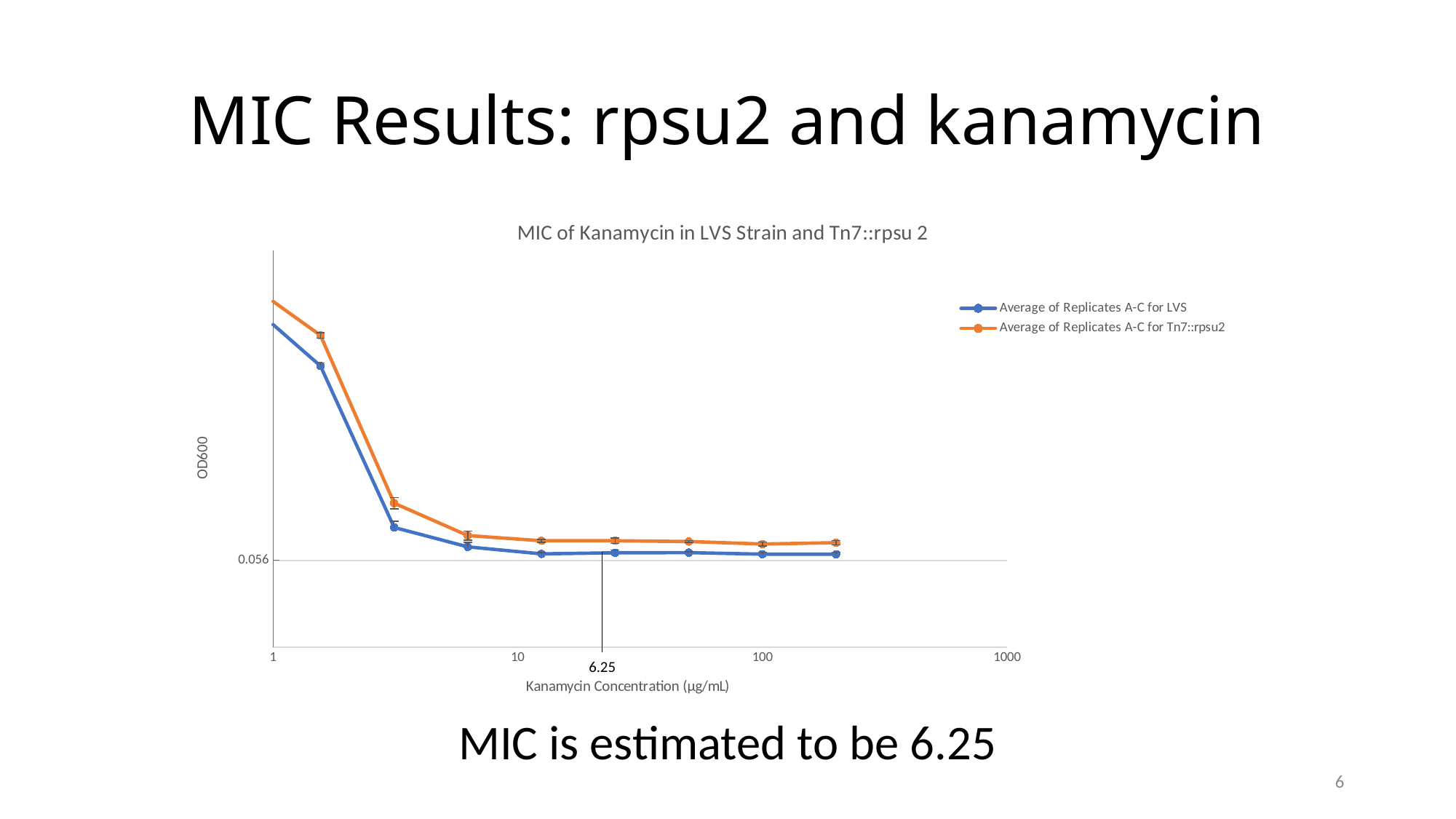
How many data points are plotted for each series? 8 Which series has the lower OD600 values across the concentration range? Average of Replicates A-C for LVS Do the OD600 values rise or fall as kanamycin concentration increases? fall At a kanamycin concentration of 1 µg/mL, which series has the higher OD600: Average of Replicates A-C for LVS or Average of Replicates A-C for Tn7::rpsu2? Average of Replicates A-C for Tn7::rpsu2 Is the OD600 value for Average of Replicates A-C for LVS at 1 µg/mL greater or less than 0.056? greater What is the title of the chart? MIC of Kanamycin in LVS Strain and Tn7::rpsu 2 At the highest plotted concentration, which series has the higher OD600? Average of Replicates A-C for Tn7::rpsu2 What kind of chart is shown on the slide? line chart Is the OD600 value for Average of Replicates A-C for Tn7::rpsu2 at 1 µg/mL greater or less than 0.056? greater What kanamycin concentration is marked on the x axis as the estimated MIC? 6.25 How many series does the legend list? 2